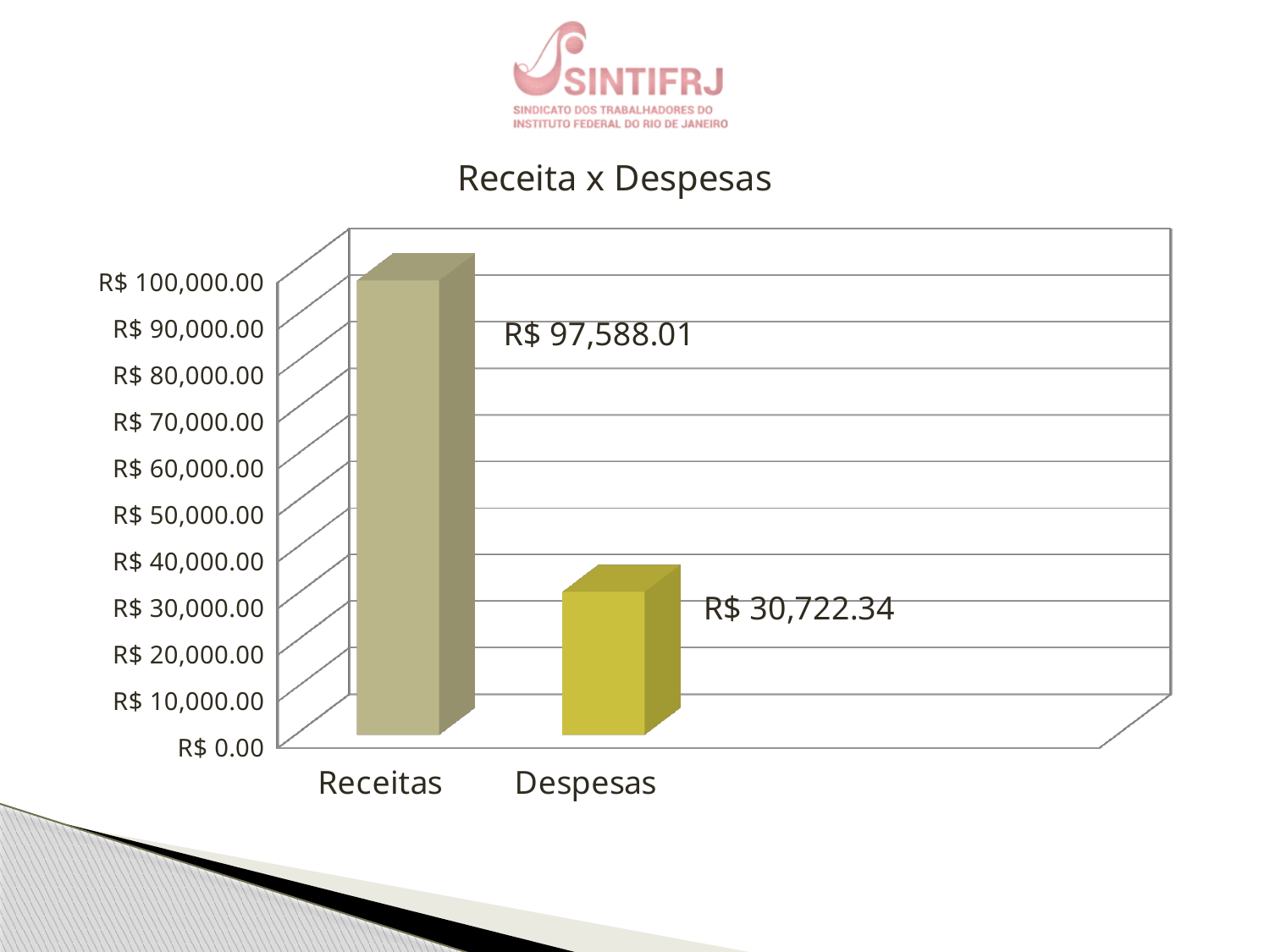
What is the value for Despesas? R$ 30,722.34 How many categories are shown in the chart? 2 Which category has the highest value? Receitas What is the difference between Receitas and Despesas? R$ 66,865.67 Is the value for Receitas greater or less than R$ 90,000.00? greater What is the value for Receitas? R$ 97,588.01 Is the value for Despesas greater or less than R$ 40,000.00? less What kind of chart is shown on the slide? bar chart What is the highest value labelled on the vertical axis? R$ 100,000.00 Which category has the lowest value? Despesas What is the title of the chart? Receita x Despesas Which is larger, Receitas or Despesas? Receitas